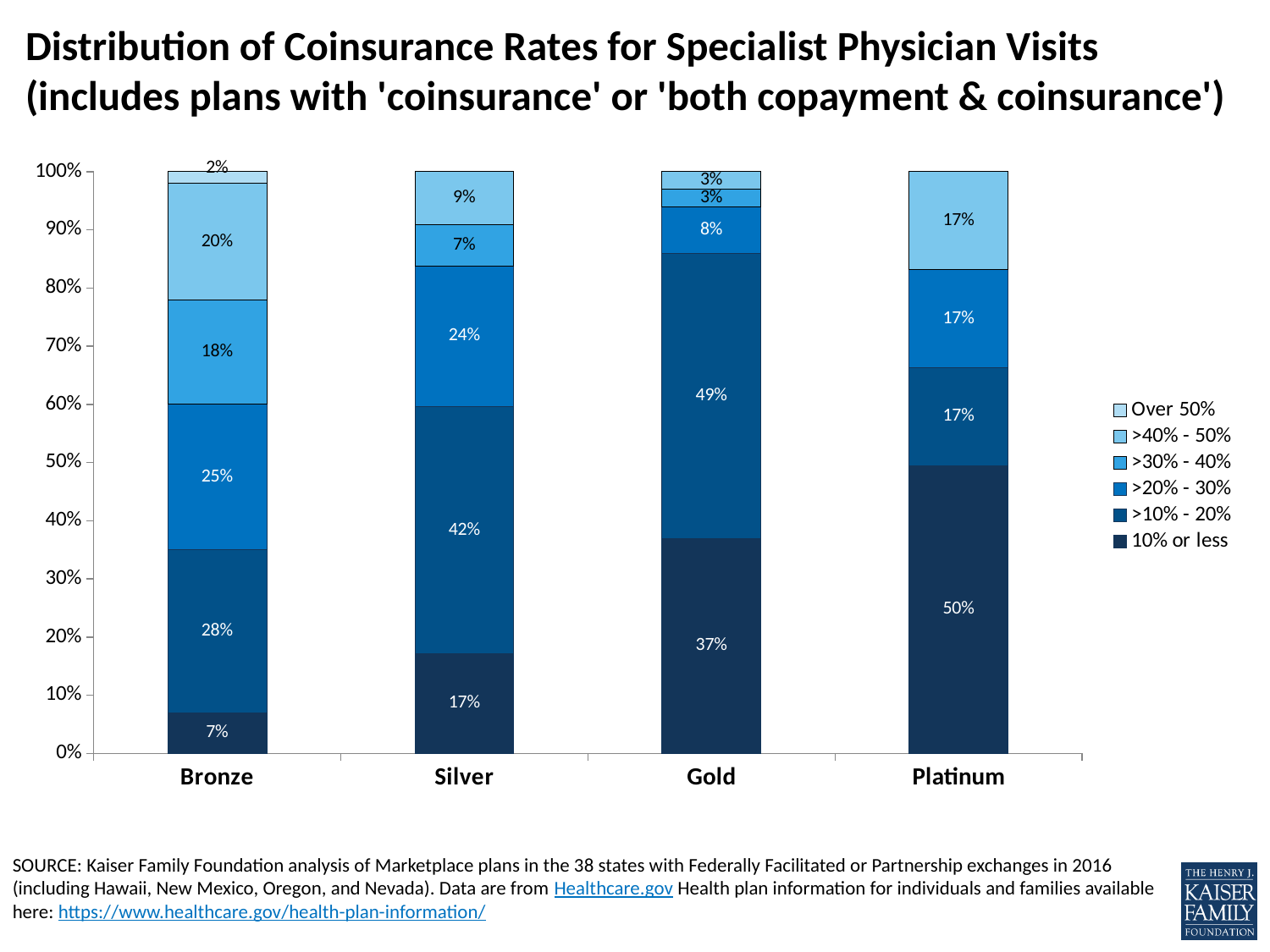
How many metal levels (categories) are shown on the x axis? 4 What percentage of Platinum plans have coinsurance of 10% or less? 50% What is the value of the Over 50% segment for Bronze? 2% What is the value of the >10% - 20% segment for Gold? 49% Which metal level has the lowest share of plans with coinsurance of 10% or less? Bronze Which metal level has the highest share of plans with coinsurance of 10% or less? Platinum How many series does the legend list? 6 What percentage of Bronze plans have coinsurance of 10% or less? 7% What is the difference in percentage points between the >10% - 20% segment for Gold and for Silver? 7 percentage points Which is larger: the >20% - 30% segment for Silver or for Gold? Silver What is the value of the >10% - 20% segment for Silver? 42% What kind of chart is shown on the slide? Stacked bar chart